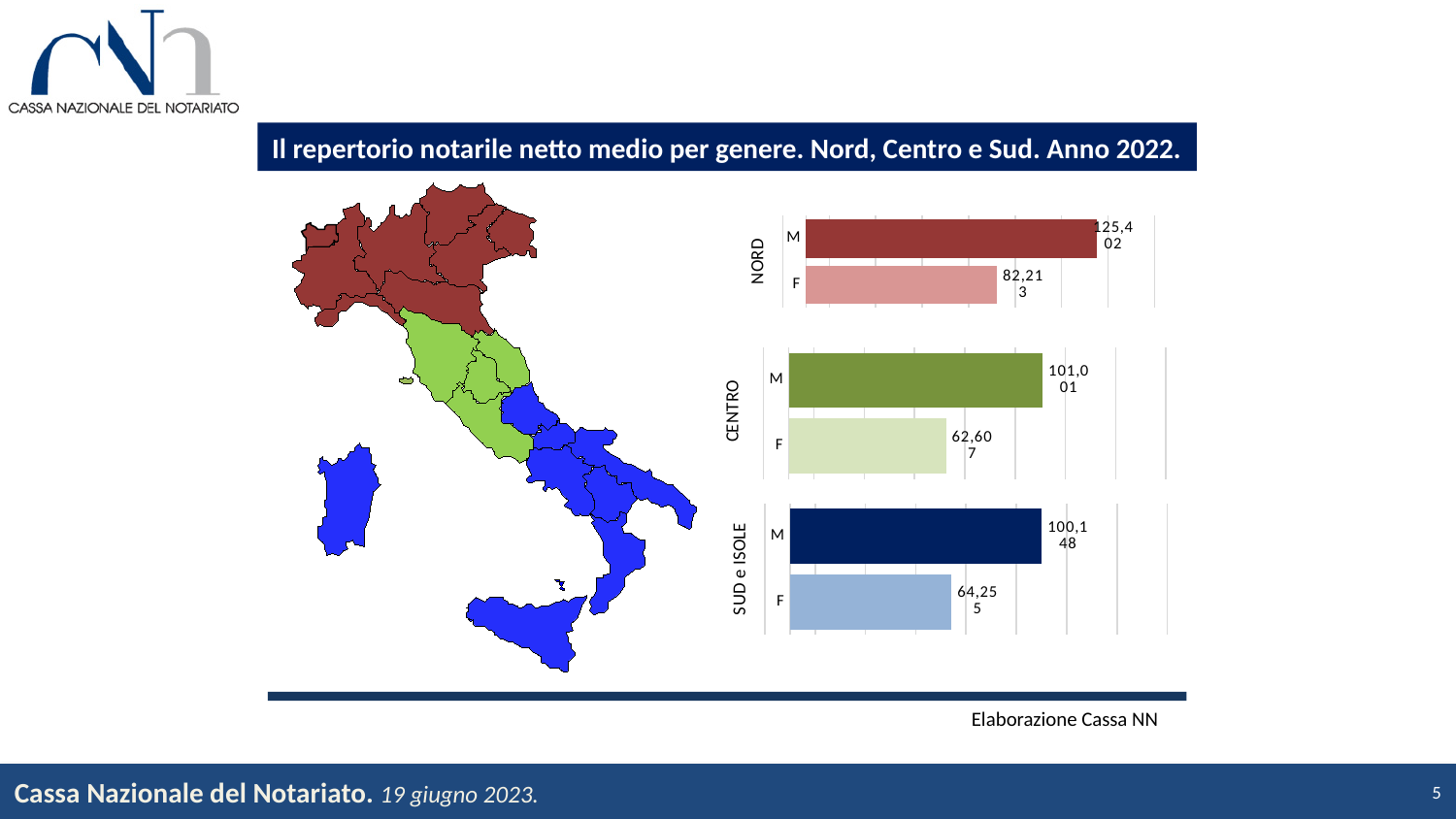
What is the value for M in the CENTRO group? 101,001 What is the value for M in the NORD group? 125,402 What is the value for F in the NORD group? 82,213 What is the difference between the M and F values in the NORD group? 43,189 What is the value for F in the SUD e ISOLE group? 64,255 Which bar has the lowest value on the chart? CENTRO F What is the value for M in the SUD e ISOLE group? 100,148 What is the value for F in the CENTRO group? 62,607 How many regional groups are shown on the chart? 3 What kind of chart is shown on the slide? Bar chart Which is larger, the M value for CENTRO or the M value for SUD e ISOLE? CENTRO M Which bar has the highest value on the chart? NORD M